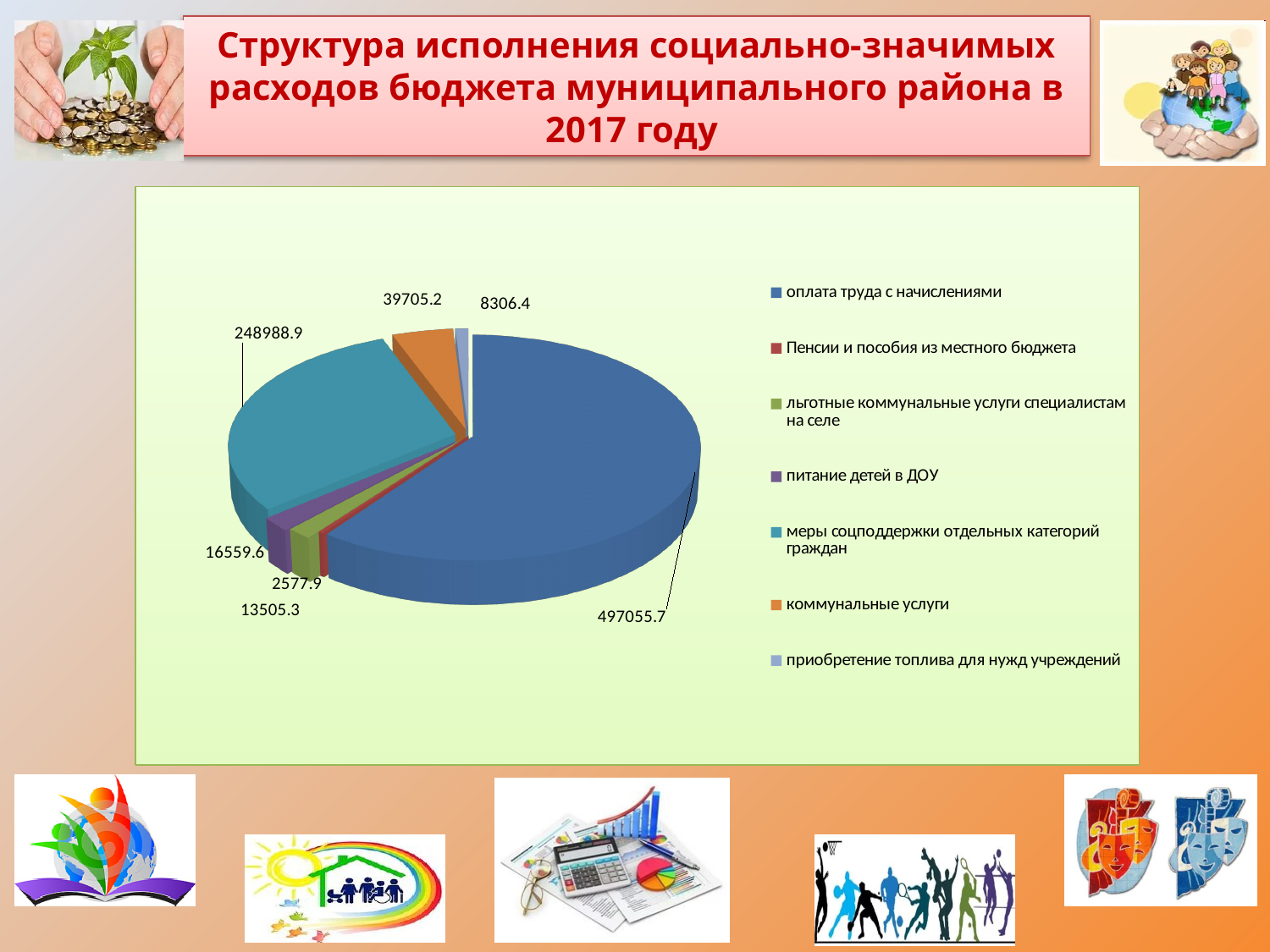
What type of chart is shown on the slide? pie chart Which category has the smallest slice of the pie? Пенсии и пособия из местного бюджета Which is larger: 'Пенсии и пособия из местного бюджета' or 'питание детей в ДОУ'? питание детей в ДОУ How many categories does the legend of the pie chart list? 7 What is the value for 'коммунальные услуги'? 39705.2 What is the value for 'питание детей в ДОУ'? 16559.6 What is the total of all slices in the pie chart? 826699.0 What is the value for 'приобретение топлива для нужд учреждений'? 8306.4 What is the value for 'меры соцподдержки отдельных категорий граждан'? 248988.9 What is the difference between the values for 'оплата труда с начислениями' and 'меры соцподдержки отдельных категорий граждан'? 248066.8 Which category has the largest slice of the pie? оплата труда с начислениями What is the value for 'оплата труда с начислениями'? 497055.7